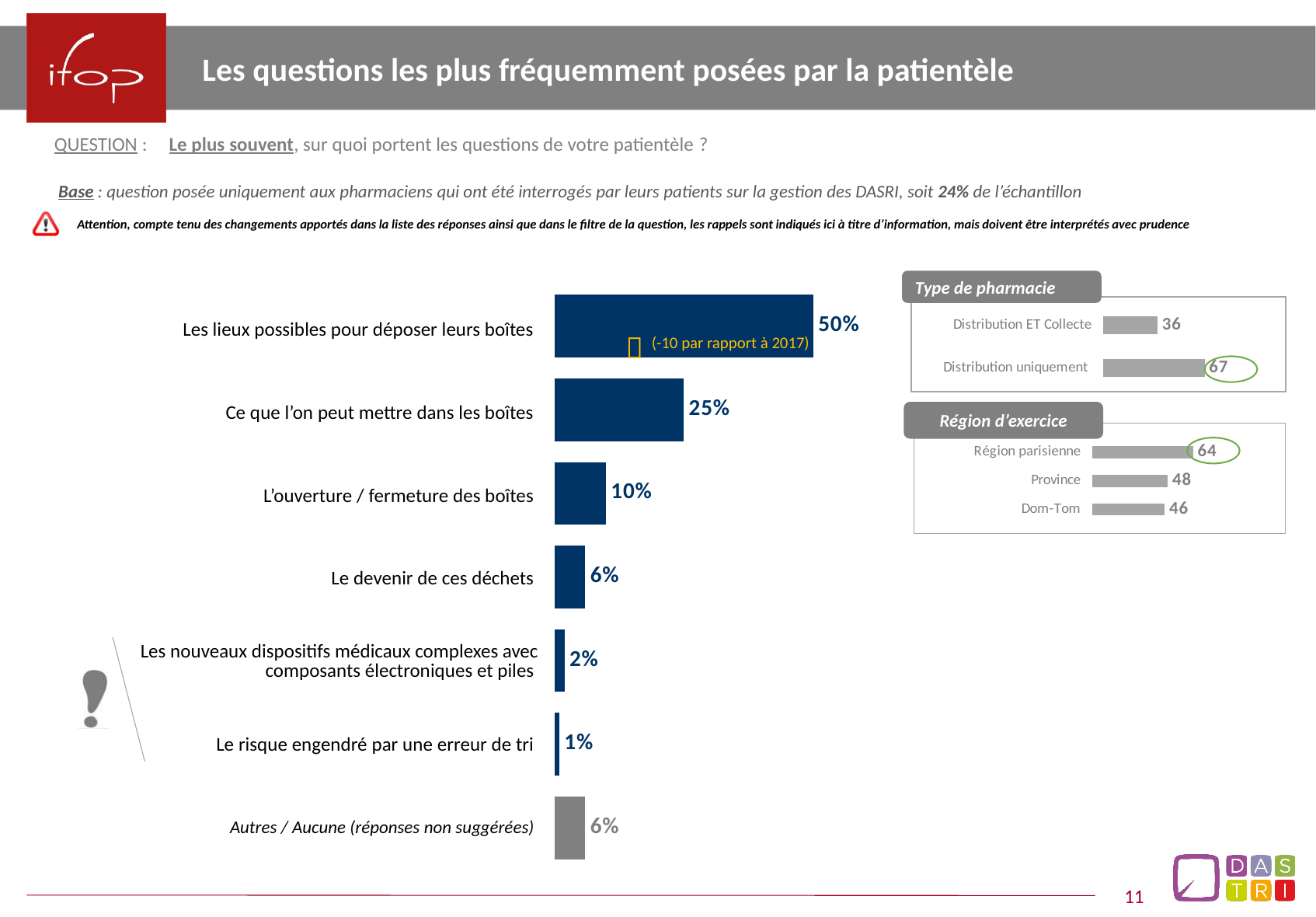
In the "Région d'exercice" chart, what is the difference between "Province" and "Dom-Tom"? 2 In the "Type de pharmacie" chart, what is the value for "Distribution uniquement"? 67 In the main bar chart, which category has the highest value? Les lieux possibles pour déposer leurs boîtes In the main bar chart, which is larger: "L'ouverture / fermeture des boîtes" or "Le devenir de ces déchets"? L'ouverture / fermeture des boîtes In the main bar chart, what is the value for "Les lieux possibles pour déposer leurs boîtes"? 50% How many categories does the main bar chart show? 7 In the main bar chart, what is the value for "Ce que l'on peut mettre dans les boîtes"? 25% In the "Région d'exercice" chart, which category has the highest value? Région parisienne In the main bar chart, which category has the lowest value? Le risque engendré par une erreur de tri In the main bar chart, what is the value for "Le risque engendré par une erreur de tri"? 1% In the main bar chart, what is the difference between "Les lieux possibles pour déposer leurs boîtes" and "Ce que l'on peut mettre dans les boîtes"? 25% What kind of chart is the main chart on the slide? Bar chart